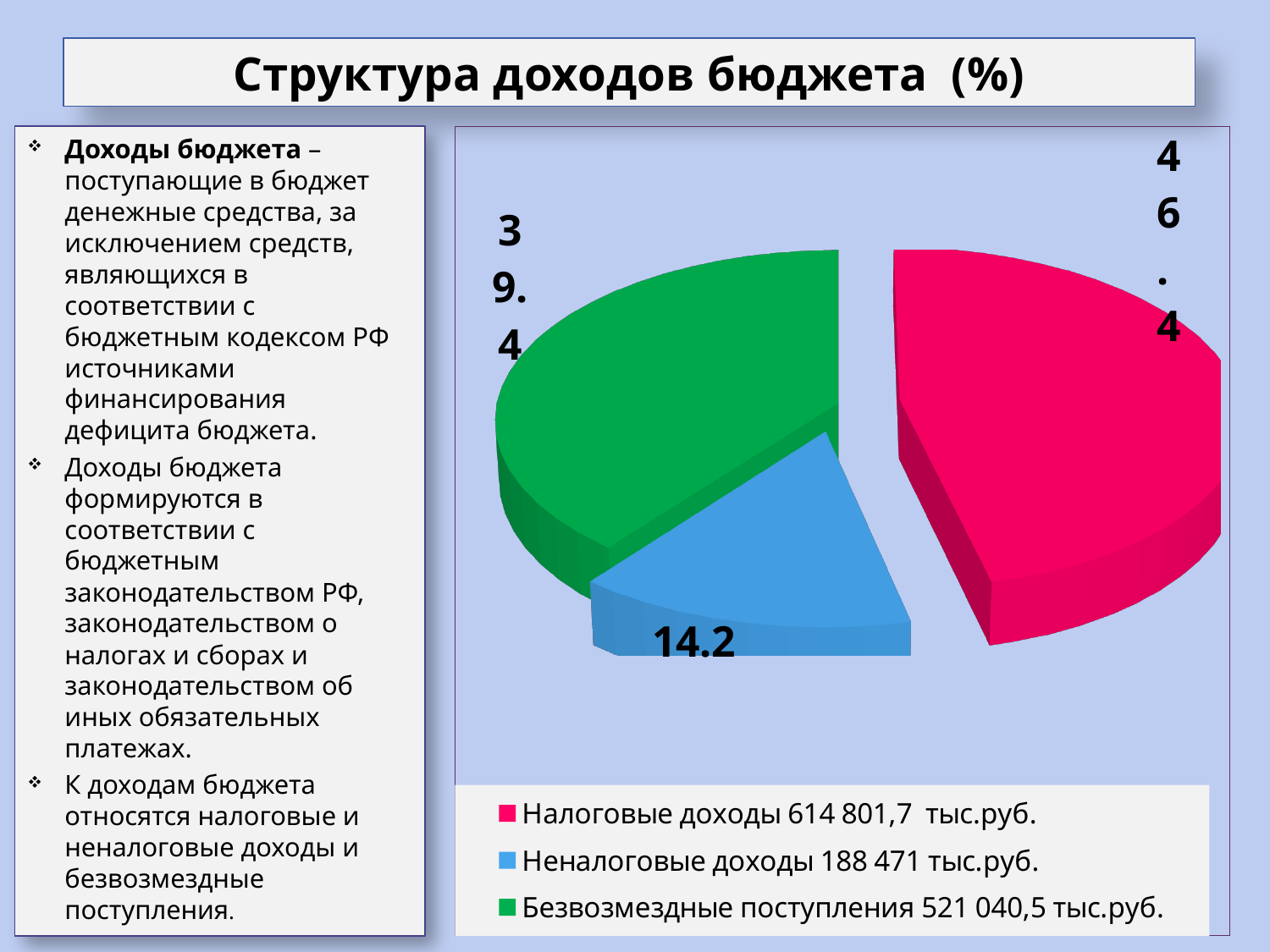
How many slices does the pie chart have? 3 What percentage is shown for Неналоговые доходы? 14.2 What percentage is shown for Безвозмездные поступления? 39.4 Which category has the largest share of the pie? Налоговые доходы What colour is the slice for Безвозмездные поступления? Green What is the title of the chart? Структура доходов бюджета (%) Which is larger: the share of Безвозмездные поступления or the share of Неналоговые доходы? Безвозмездные поступления What kind of chart is shown on the slide? Pie chart What amount in тыс.руб. does the legend give for Неналоговые доходы? 188 471 тыс.руб. What is the difference in percentage points between Налоговые доходы and Безвозмездные поступления? 7 Which category has the smallest share of the pie? Неналоговые доходы What percentage is shown for Налоговые доходы? 46.4